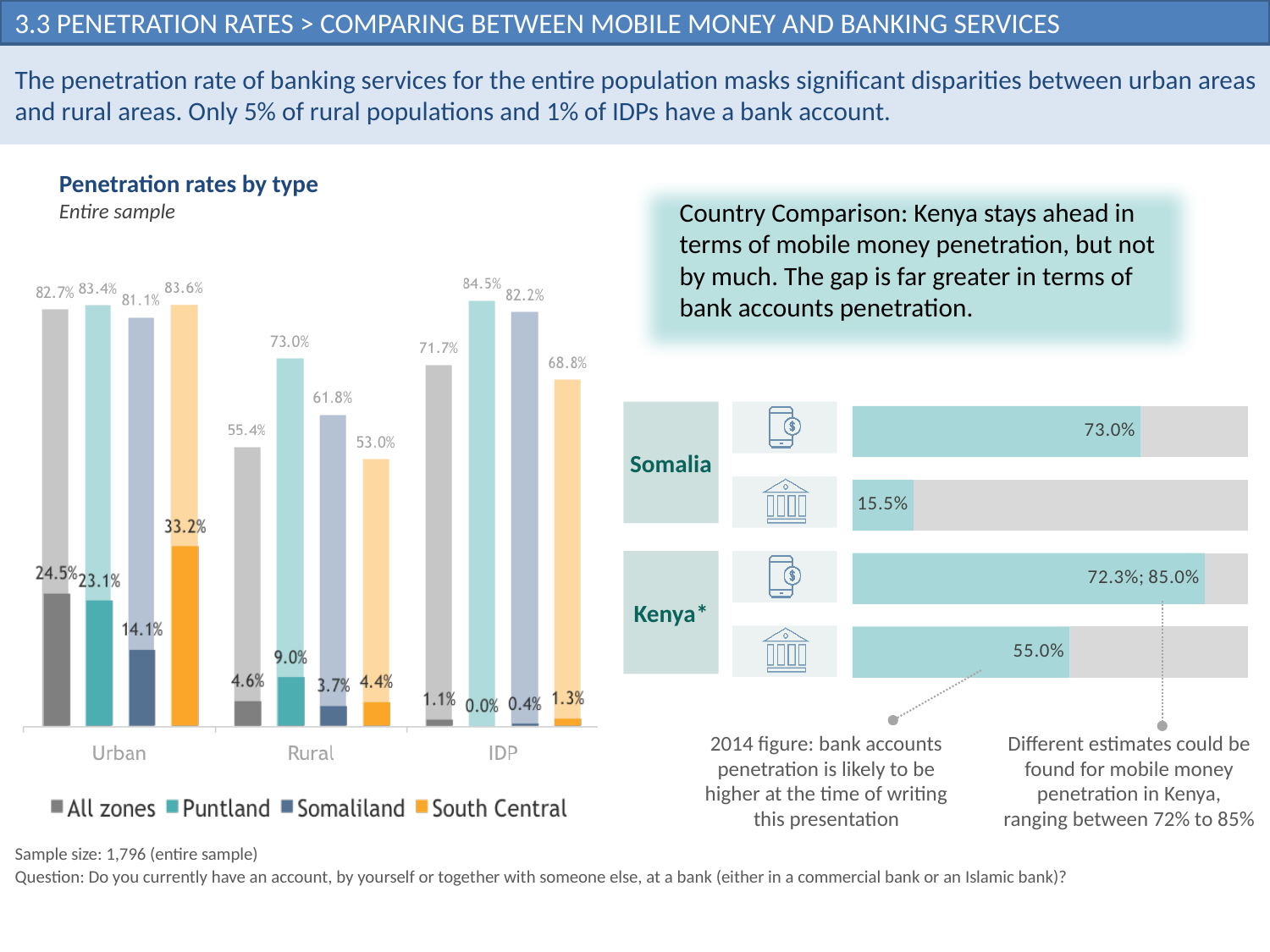
In the 'Penetration rates by type' chart, which series has the highest darker (shorter) bar for Urban? South Central In the country comparison graphic on the right, what is the bank account penetration shown for Somalia? 15.5% In the 'Penetration rates by type' chart, what is the value of the darker (shorter) All zones bar for IDP? 1.1% In the 'Penetration rates by type' chart, which is larger for Rural: the lighter Somaliland bar or the lighter South Central bar? Somaliland In the 'Penetration rates by type' chart, how many series does the legend list? 4 In the 'Penetration rates by type' chart, which series has the lowest darker (shorter) bar for IDP? Puntland In the country comparison graphic on the right, what is the bank account penetration shown for Kenya? 55.0% In the 'Penetration rates by type' chart, what is the difference between the darker Puntland bar for Rural (9.0%) and the darker Somaliland bar for Rural (3.7%)? 5.3% In the 'Penetration rates by type' chart, how many categories are shown on the x axis? 3 What type of chart is 'Penetration rates by type'? bar chart In the 'Penetration rates by type' chart, what is the value of the darker (shorter) South Central bar for Urban? 33.2% In the 'Penetration rates by type' chart, what is the value of the lighter (taller) Puntland bar for Rural? 73.0%